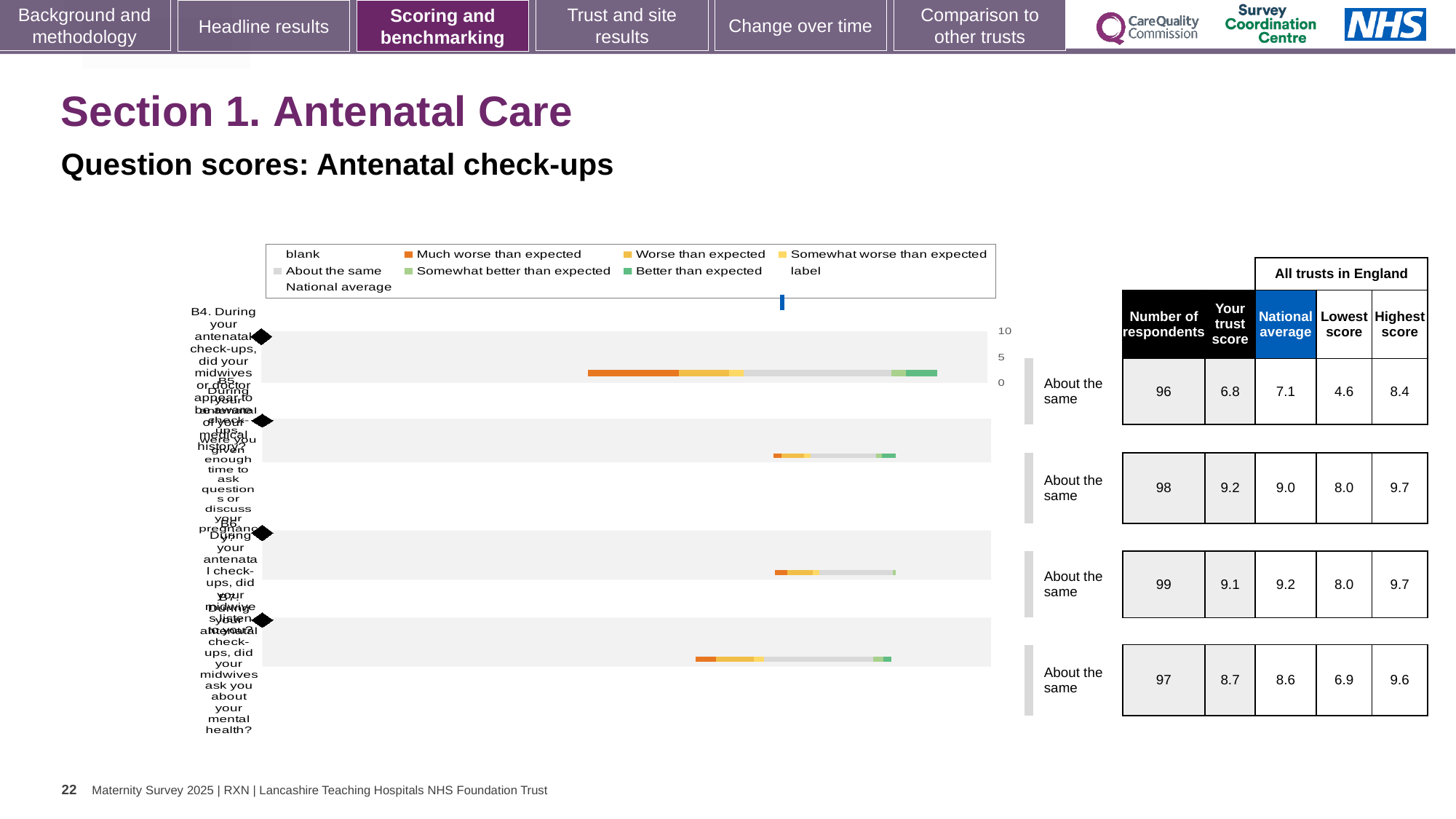
In the chart legend, what colour represents 'Much worse than expected'? orange For question B4, what is the difference between the national average and the trust score shown in the table? 0.3 What benchmark category is shown for all four questions in the chart? About the same For question B6, which is larger: the trust score or the national average? national average Which question has the lowest trust score in the table beside the chart? B4 According to the table beside the chart, what is the trust score for question B4? 6.8 What kind of chart is shown on the slide? bar chart How many questions (bars) are plotted in the chart? 4 According to the table beside the chart, what is the national average for question B5? 9.0 Which question has the highest trust score in the table beside the chart? B5 In the chart legend, what colour represents 'Better than expected'? green According to the table beside the chart, how many respondents answered question B7? 97